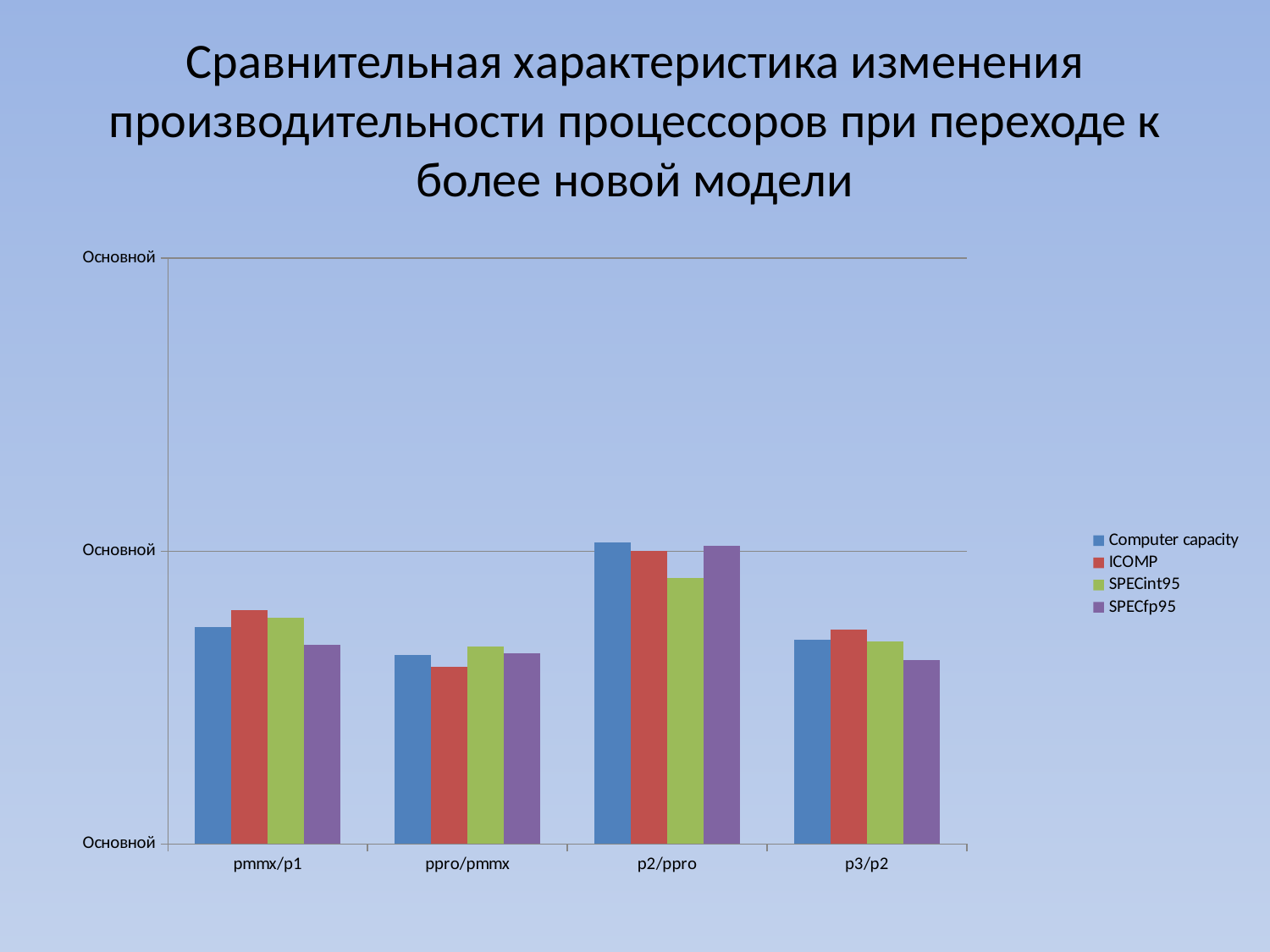
What kind of chart is shown on the slide? bar chart Which series is shown in red in the chart's legend? ICOMP Which category has the lowest ICOMP value? ppro/pmmx For pmmx/p1, which is larger: ICOMP or SPECfp95? ICOMP Which category has the highest SPECfp95 value? p2/ppro How many series does the chart's legend list? 4 Which category has the highest Computer capacity value? p2/ppro How many categories are shown on the x axis of the chart? 4 For ppro/pmmx, which is larger: SPECint95 or ICOMP? SPECint95 For p2/ppro, which is larger: Computer capacity or SPECint95? Computer capacity Which category has the lowest Computer capacity value? ppro/pmmx Which category has the highest ICOMP value? p2/ppro